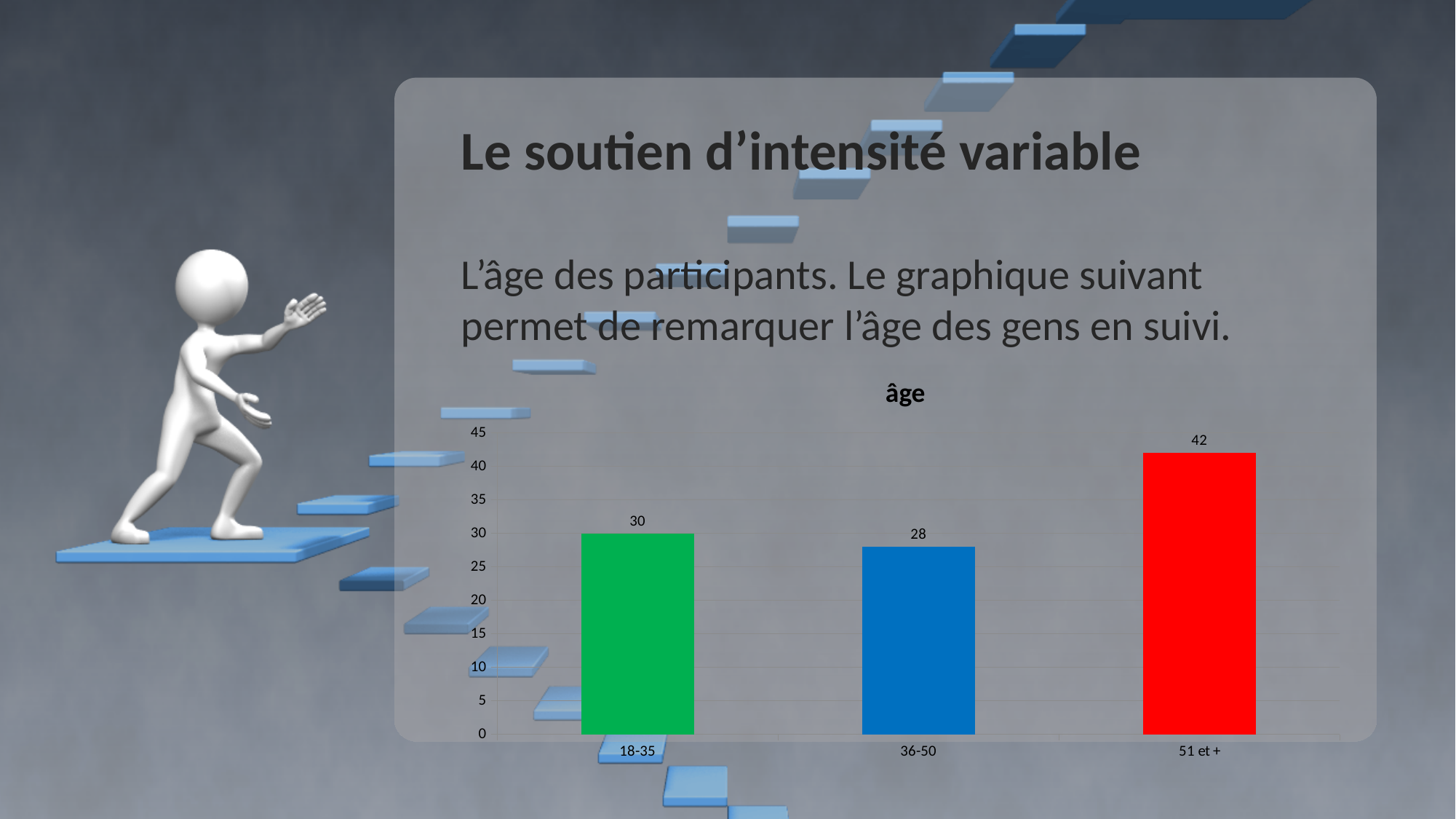
How many age categories are shown in the chart? 3 What is the value for the 51 et + category? 42 What kind of chart is shown on the slide? bar chart What is the value for the 36-50 category? 28 Which is larger, the value for 18-35 or the value for 51 et +? 51 et + What is the title of the chart? âge What is the difference between the values for 51 et + and 18-35? 12 Is the value for 36-50 greater or less than 30? less What is the difference between the values for 18-35 and 36-50? 2 Which age category has the lowest value? 36-50 Which age category has the highest value? 51 et + What is the value for the 18-35 category? 30